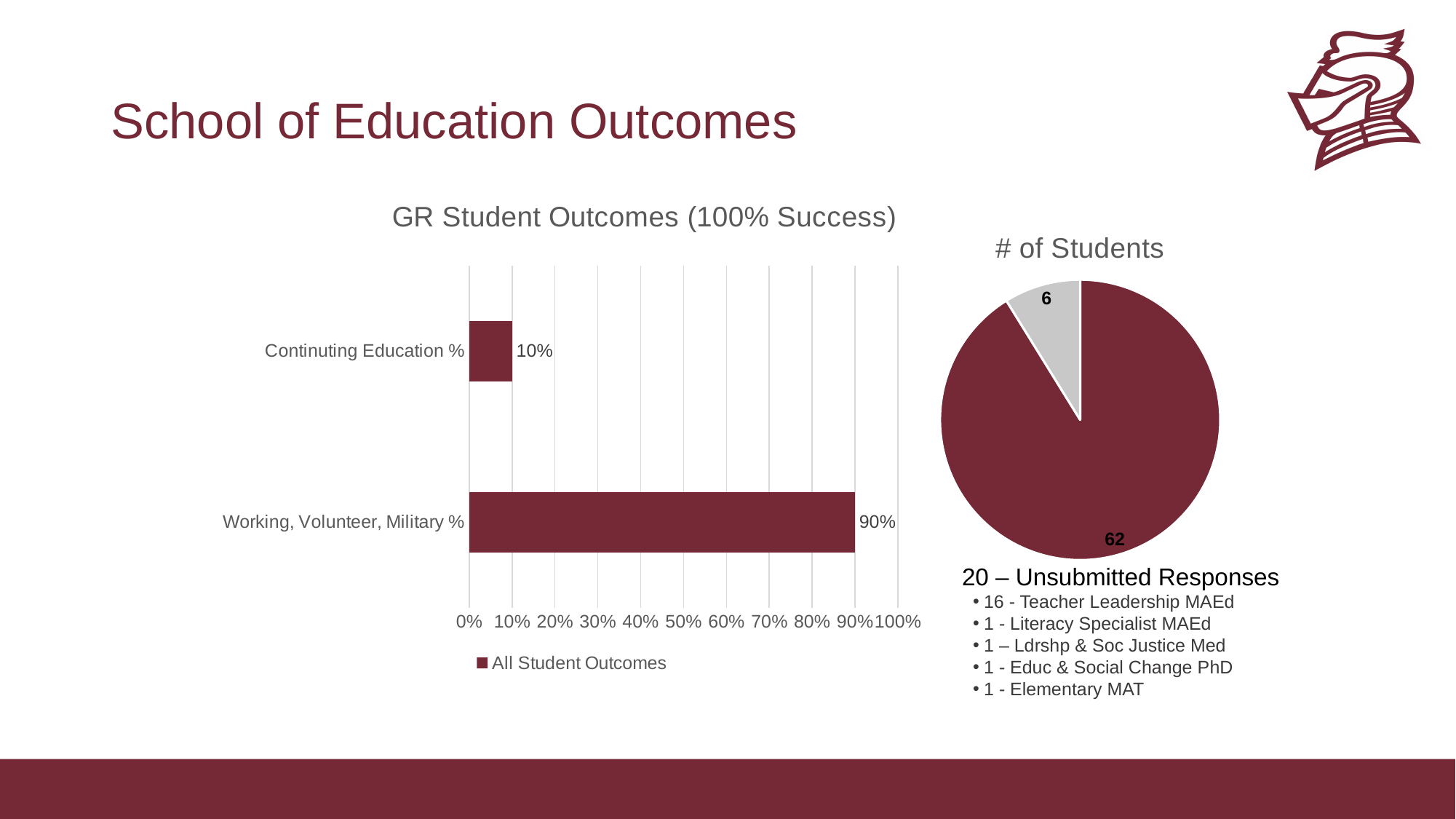
What kind of chart is the GR Student Outcomes (100% Success) chart? Bar chart In the GR Student Outcomes (100% Success) chart, what is the value for Continuting Education %? 10% In the GR Student Outcomes (100% Success) chart, how many categories are plotted? 2 What kind of chart is the # of Students chart? Pie chart In the GR Student Outcomes (100% Success) chart, how many series does the legend list? 1 In the # of Students pie chart, what is the total of the two slices shown? 68 In the GR Student Outcomes (100% Success) chart, what is the name of the series shown in the legend? All Student Outcomes In the GR Student Outcomes (100% Success) chart, what is the difference between the Working, Volunteer, Military % value and the Continuting Education % value? 80% In the GR Student Outcomes (100% Success) chart, what is the value for Working, Volunteer, Military %? 90% In the GR Student Outcomes (100% Success) chart, which category has the highest value? Working, Volunteer, Military % In the GR Student Outcomes (100% Success) chart, which category has the lowest value? Continuting Education % In the # of Students pie chart, what is the value of the largest slice? 62